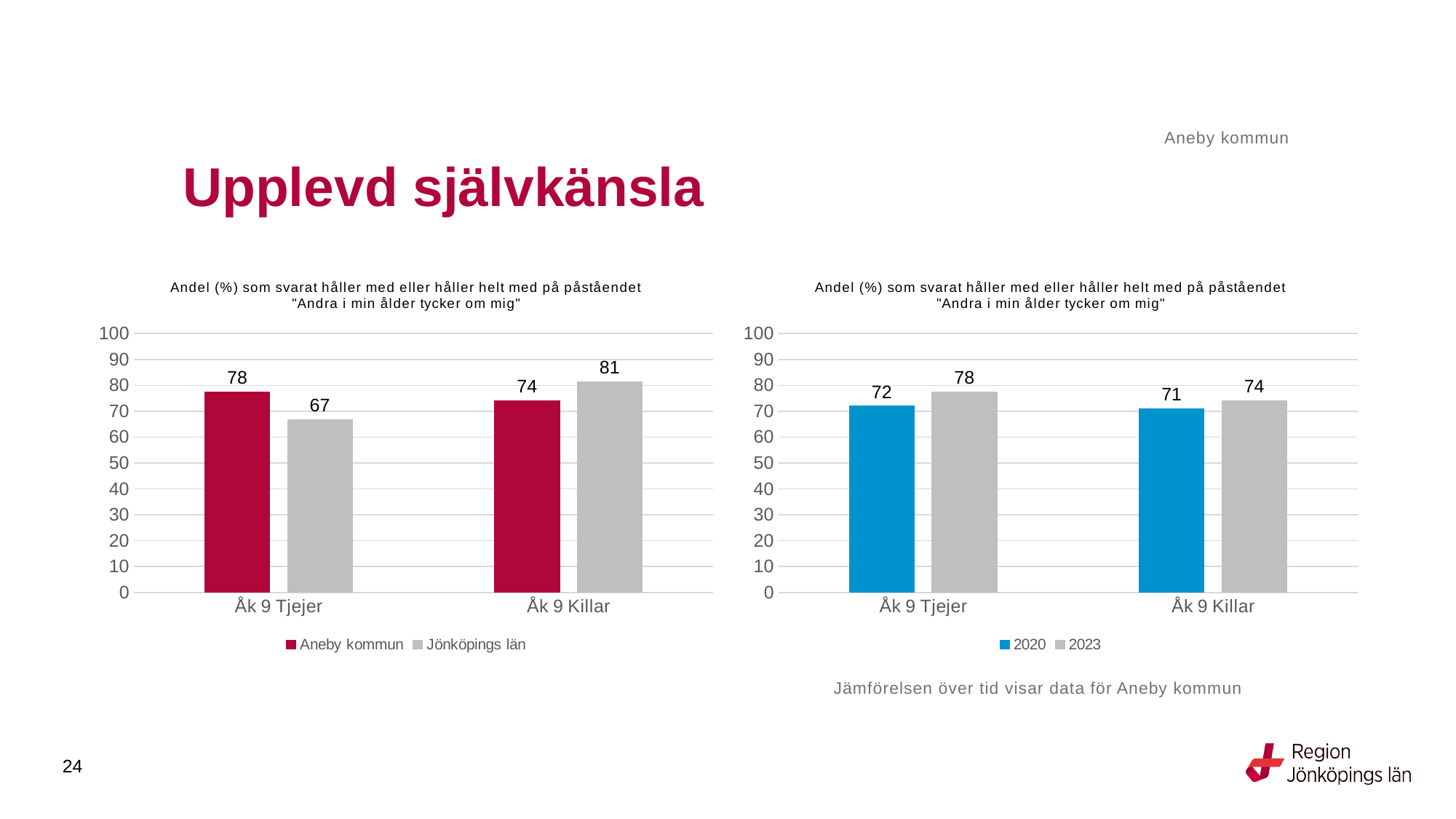
How many categories are shown on the x axis of the right chart? 2 In the right chart, what is the value for 2020 for Åk 9 Killar? 71 In the right chart, what is the difference between 2023 and 2020 for Åk 9 Tjejer? 6 In the left chart, what is the value for Jönköpings län for Åk 9 Killar? 81 In the left chart, which is larger for Åk 9 Killar: Aneby kommun or Jönköpings län? Jönköpings län In the left chart, which bar has the lowest value? Jönköpings län, Åk 9 Tjejer What kind of chart is the left chart? Bar chart In the left chart, what is the value for Aneby kommun for Åk 9 Tjejer? 78 In the right chart, which bar has the highest value? 2023, Åk 9 Tjejer How many series does the legend of the right chart list? 2 In the left chart, what is the difference between Aneby kommun and Jönköpings län for Åk 9 Tjejer? 11 In the right chart, what is the value for 2023 for Åk 9 Tjejer? 78